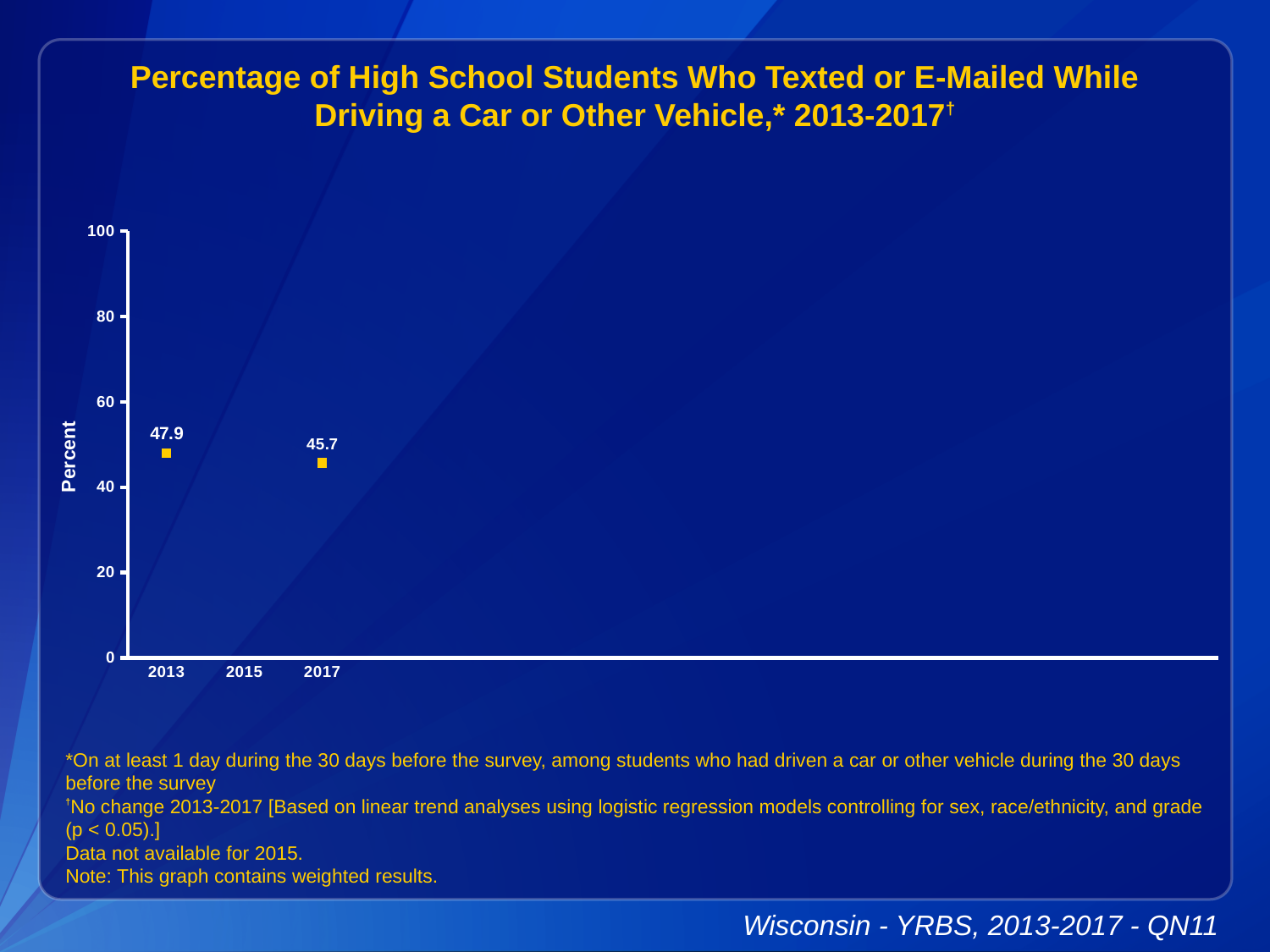
Do the plotted values rise or fall from 2013 to 2017? fall What is the label of the y axis? Percent Is the value for 2013 greater or less than 40? greater Is the value for 2017 greater or less than 60? less How many data points are plotted on the chart? 2 What is the value for 2013? 47.9 Which year on the x axis has no data point plotted? 2015 Which year has the lowest plotted value? 2017 Which year has the highest value? 2013 What is the difference between the 2013 and 2017 values? 2.2 What is the value for 2017? 45.7 Which is larger, the value for 2013 or the value for 2017? 2013